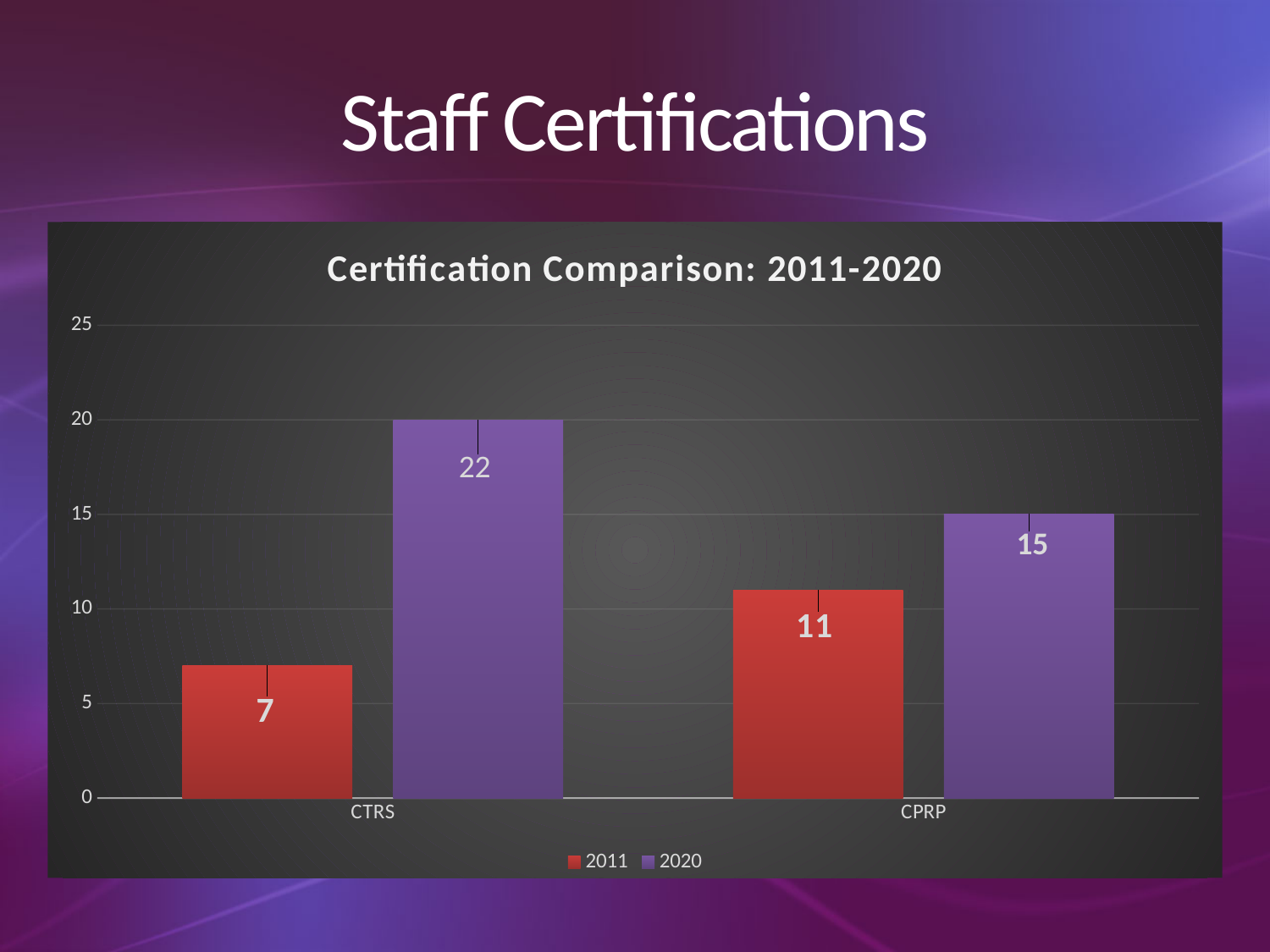
Which category has the lowest value in 2011? CTRS What is the title of the chart? Certification Comparison: 2011-2020 Which is larger, the 2011 value for CPRP or the 2011 value for CTRS? CPRP What type of chart is shown on the slide? bar chart What is the value for CTRS in 2011? 7 How many series does the legend list? 2 How many categories are shown on the x axis? 2 What is the difference between the 2020 and 2011 values for CPRP? 4 What is the value for CPRP in 2020? 15 What is the value for CPRP in 2011? 11 Which category has the highest value in 2020? CTRS